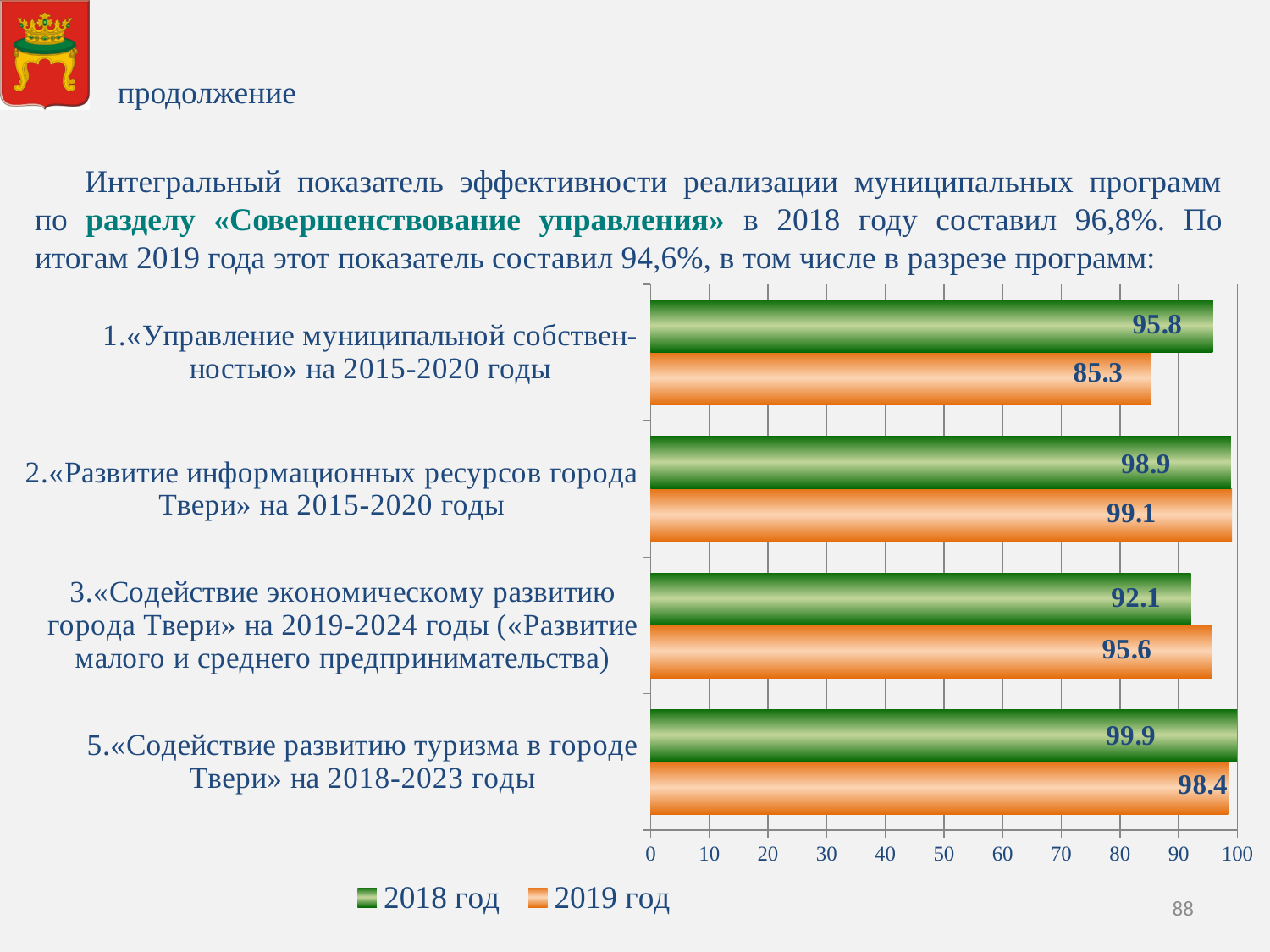
What kind of chart is shown on the slide? bar chart How many series does the legend list? 2 What is the 2019 год value for «Развитие информационных ресурсов города Твери» на 2015-2020 годы? 99.1 How many programs (categories) are shown in the chart? 4 For «Содействие экономическому развитию города Твери», which is larger: the 2018 год value or the 2019 год value? 2019 год What is the 2018 год value for «Управление муниципальной собственностью» на 2015-2020 годы? 95.8 Which program has the highest 2018 год value? «Содействие развитию туризма в городе Твери» на 2018-2023 годы Which program has the lowest 2019 год value? «Управление муниципальной собственностью» на 2015-2020 годы What is the 2019 год value for «Содействие экономическому развитию города Твери» на 2019-2024 годы? 95.6 What is the 2018 год value for «Содействие развитию туризма в городе Твери» на 2018-2023 годы? 99.9 What is the difference between the 2018 год and 2019 год values for «Управление муниципальной собственностью» на 2015-2020 годы? 10.5 Is the 2019 год value for «Управление муниципальной собственностью» greater or less than 90? less